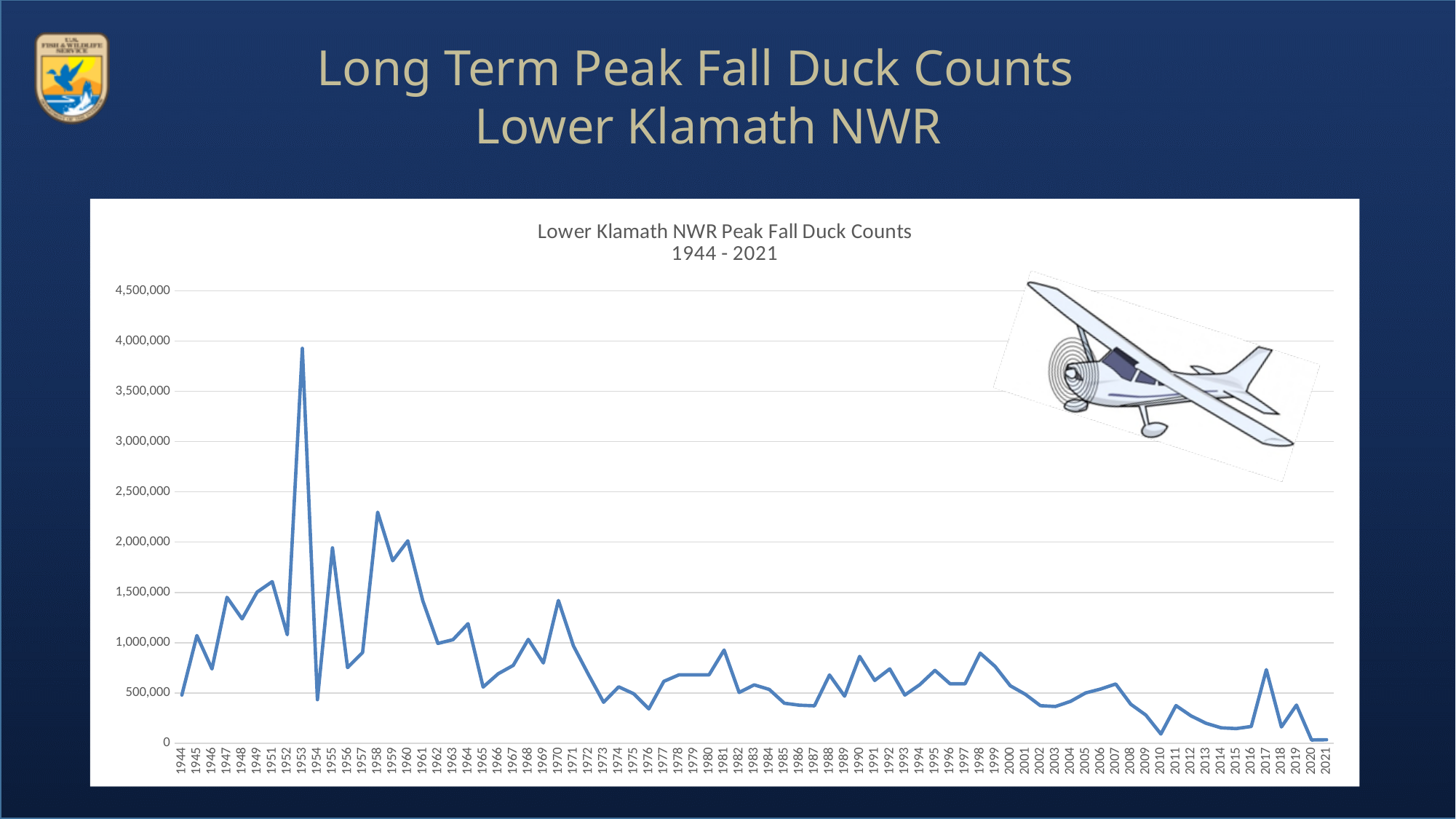
What kind of chart is shown on the slide? Line chart Overall, do the duck counts rise or fall from the 1950s to 2021? fall Is the value for 1958 greater or less than 2,000,000? greater Which year has the larger duck count, 1958 or 1960? 1958 Is the value for 1970 greater or less than 1,000,000? greater What is the title of the chart? Lower Klamath NWR Peak Fall Duck Counts 1944 - 2021 Is the value for 1981 greater or less than 500,000? greater What is the highest value labelled on the vertical axis? 4,500,000 Which year has the larger duck count, 1953 or 1958? 1953 In which year was the peak fall duck count highest? 1953